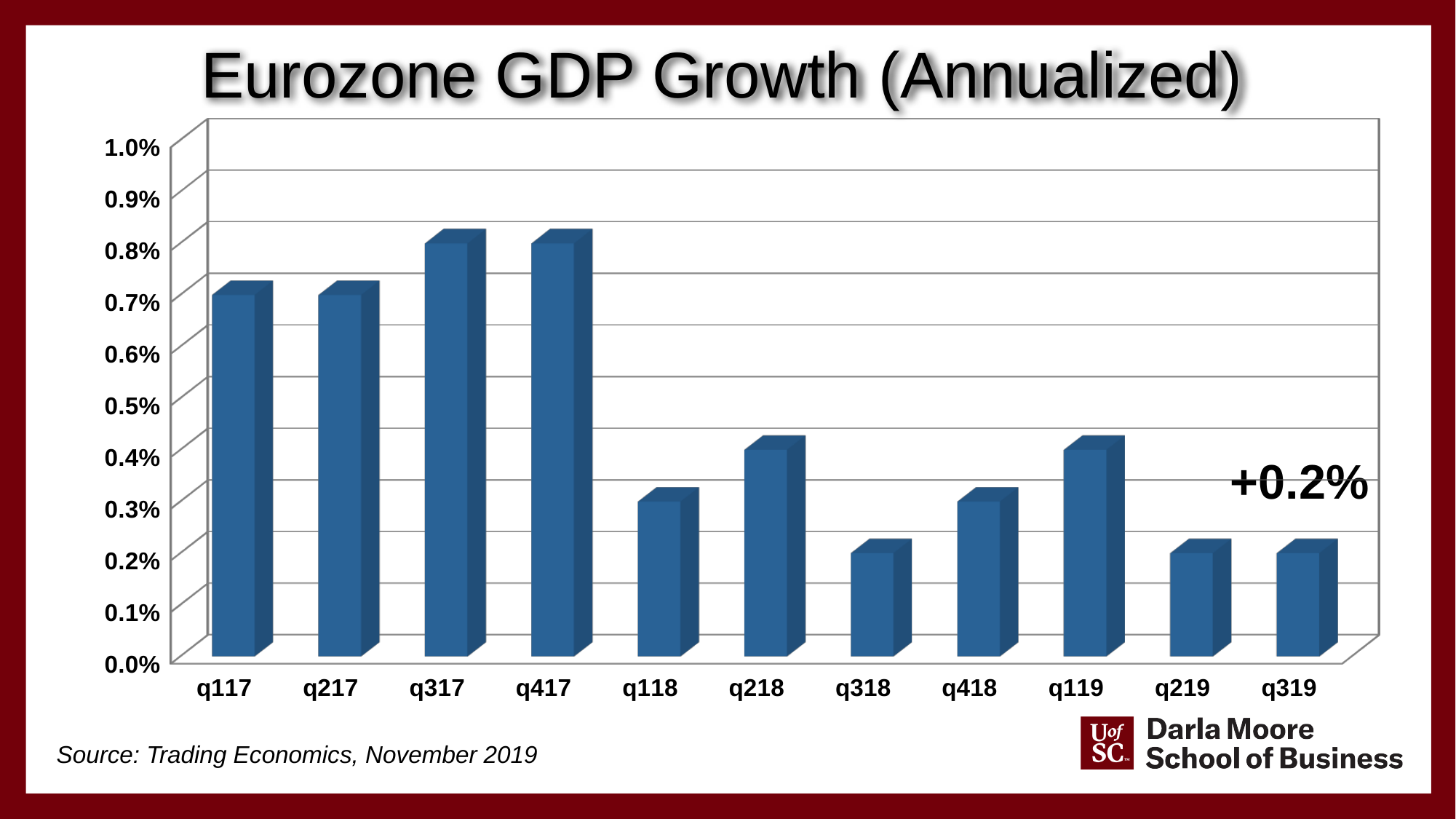
Which is larger, the value for q318 or the value for q418? q418 What is the value of the bar for q118? 0.3% What is the Eurozone GDP growth value shown for q319? +0.2% What is the value of the bar for q119? 0.4% How many quarters are shown on the x axis of the chart? 11 Overall, do the values rise or fall from q117 to q319? Fall What is the difference between the value for q417 and the value for q319? 0.6% Which is larger, the value for q217 or the value for q218? q217 What kind of chart is used to show Eurozone GDP growth? Bar chart Is the value for q317 greater or less than 0.5%? greater Is the value for q218 greater or less than 0.5%? less What is the value of the bar for q417? 0.8%